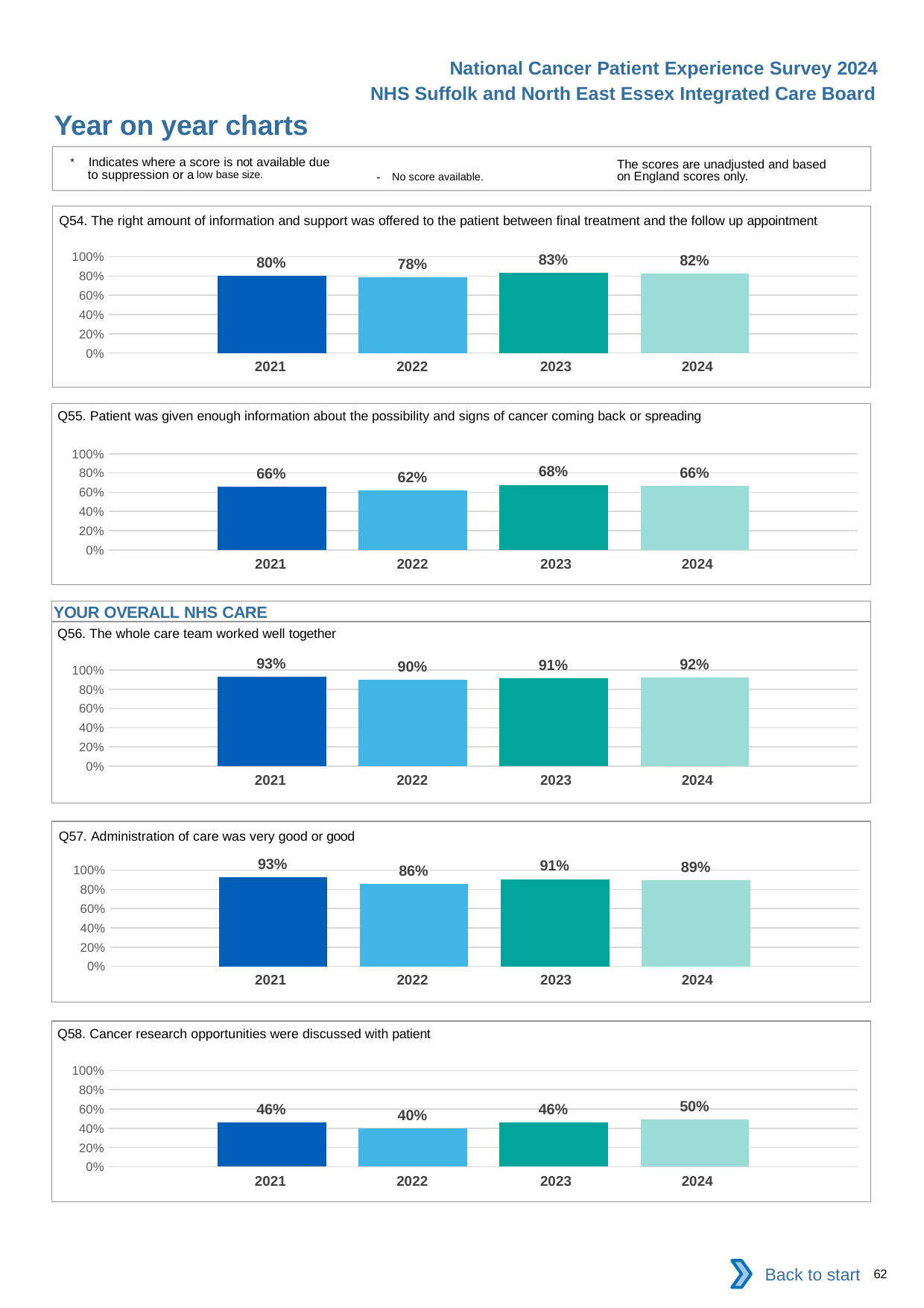
In the Q55 chart, which year has the lowest value? 2022 In the Q55 chart, what is the value for 2024? 66% In the Q54 chart, which is larger, the value for 2021 or the value for 2022? 2021 In the Q56 chart, what is the value for 2021? 93% How many years are shown in the Q55 chart? 4 In the Q57 chart, what is the difference between the 2021 and 2022 values? 7% In the Q54 chart, what is the value for 2023? 83% In the Q58 chart, which year has the highest value? 2024 What kind of chart is the Q57 chart? bar chart What is the section heading shown above the Q56 chart? YOUR OVERALL NHS CARE In the Q58 chart, is the value for 2022 greater or less than 60%? less In the Q56 chart, what is the difference between the 2024 and 2022 values? 2%